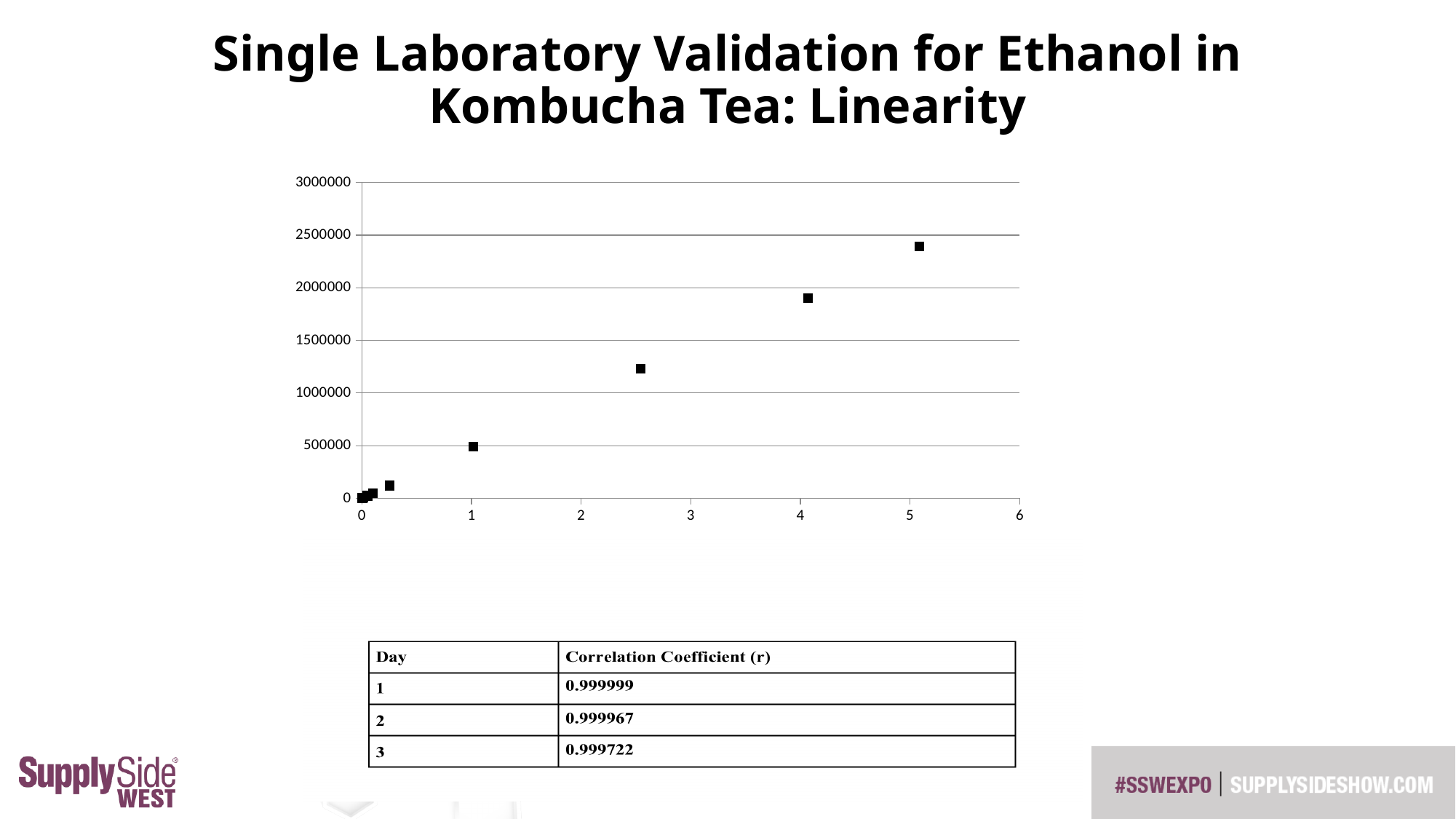
Is the value of the point plotted at about x = 2.5 greater or less than 1500000? less Is the value of the point plotted at about x = 5 greater or less than 2000000? greater Is the value of the point plotted at about x = 2.5 greater or less than 1000000? greater What is the maximum value shown on the x-axis of the chart? 6 Do the plotted values rise or fall as the x-axis value increases? rise What is the maximum value shown on the y-axis of the chart? 3000000 Which plotted point has the highest y value: the one at about x = 4 or the one at about x = 5? the one at about x = 5 What kind of chart is shown on the slide? scatter chart